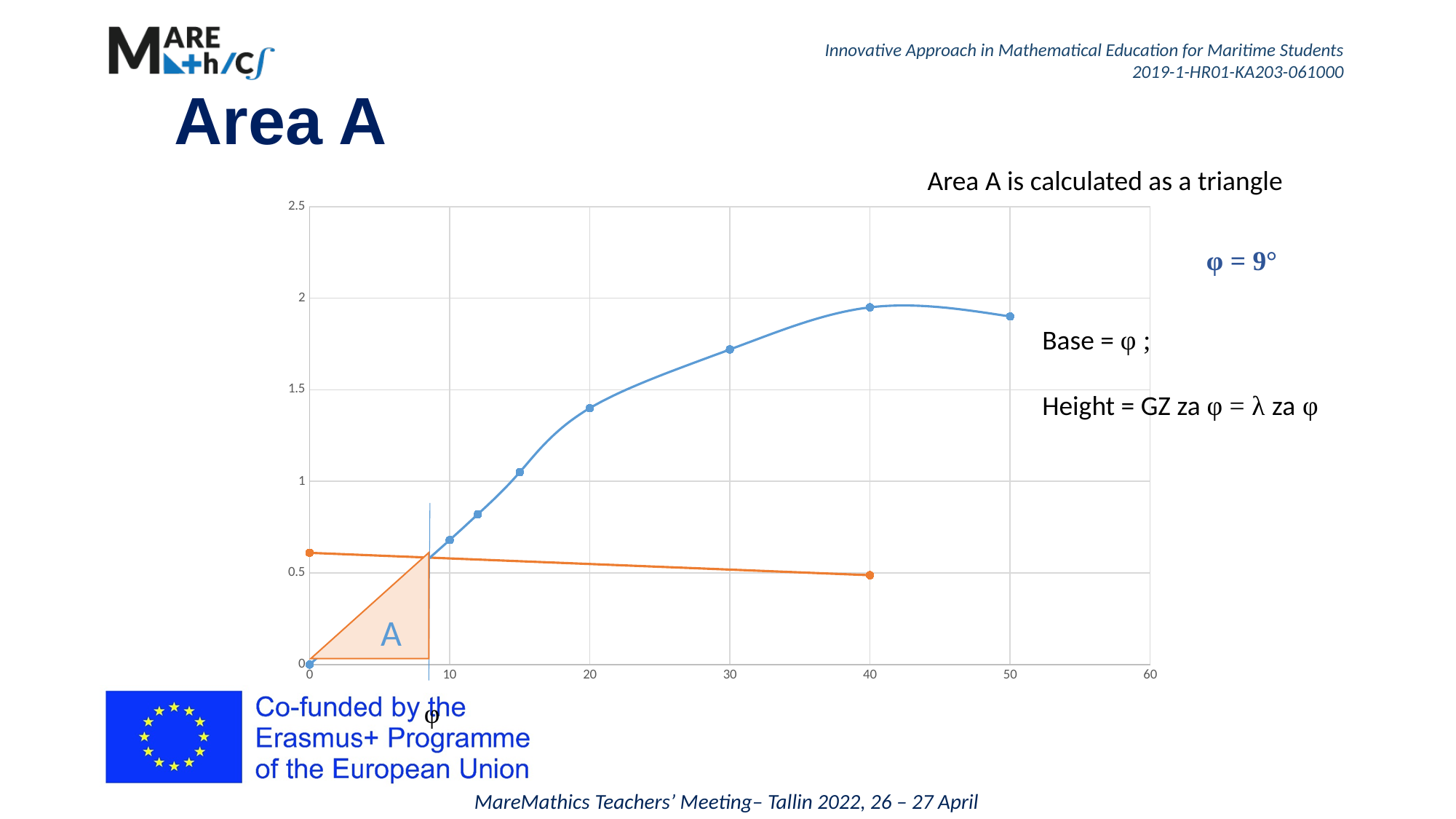
Is the value of the orange line at x = 0 greater or less than 0.5? greater Does the orange line rise or fall as x increases from 0 to 40? fall What letter labels the shaded triangle in the lower-left corner of the chart? A Is the value of the blue line at x = 10 greater or less than 0.5? greater Is the value of the blue line at x = 30 greater or less than 1.5? greater What kind of chart is shown on the slide? line chart Does the blue line rise or fall as x increases from 0 to 30? rise How many data points are marked on the orange line? 2 Which is larger: the orange line's value at x = 0 or its value at x = 40? x = 0